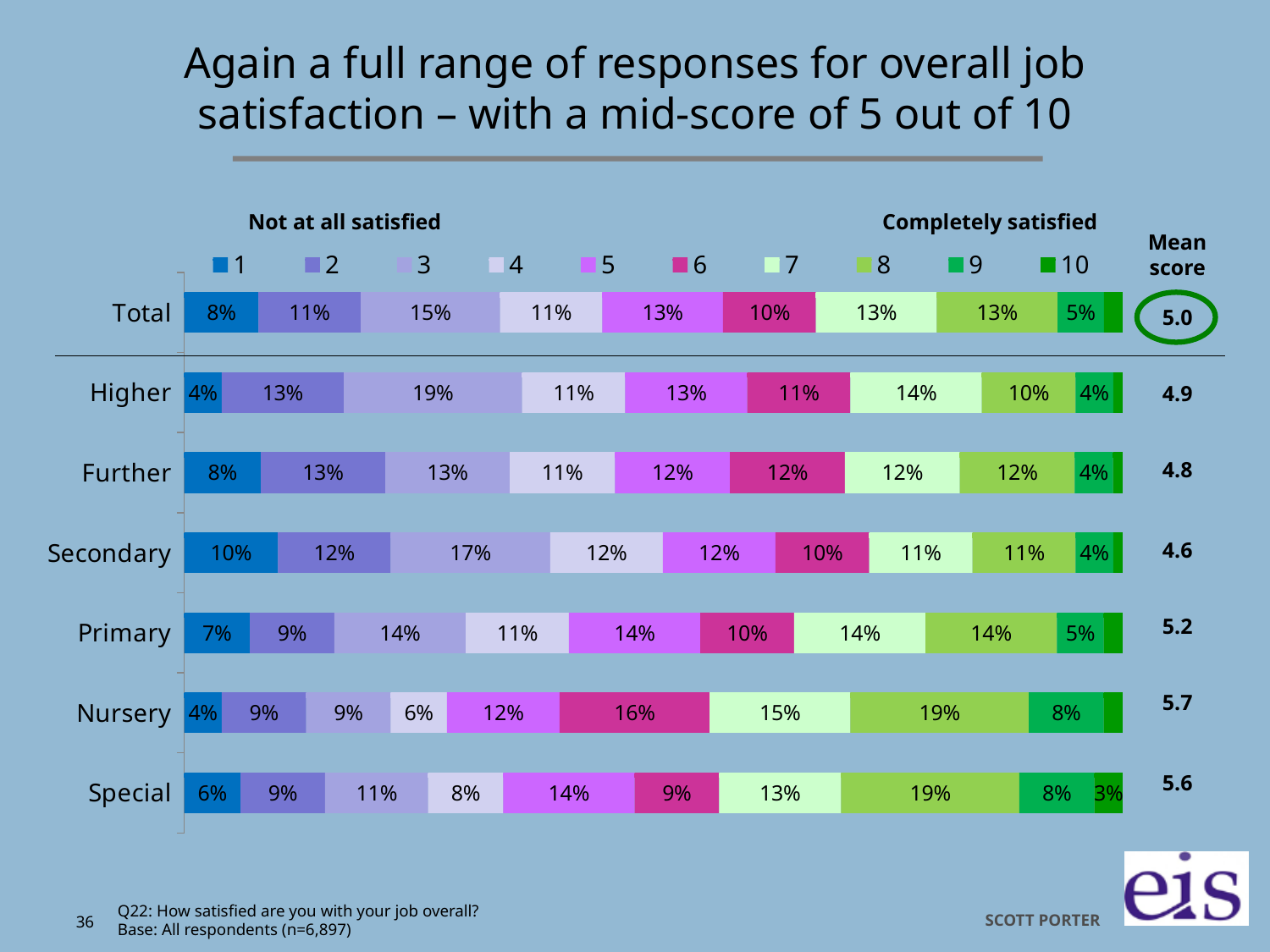
Which category has the lowest percentage giving a score of 4? Nursery What is the difference between the percentage giving a score of 8 for Nursery and for Primary? 5% Which category has the highest percentage giving a score of 6? Nursery Which is larger: the percentage giving a score of 6 for Nursery or for Special? Nursery How many categories (bars) are shown in the chart? 7 What is the mean score shown for the Nursery category? 5.7 What percentage of Nursery respondents gave a score of 8? 19% How many series does the legend list? 10 What percentage of Higher respondents gave a score of 3? 19% What percentage of Total respondents gave a score of 3? 15% What kind of chart is shown on the slide? Stacked bar chart What percentage of Special respondents gave a score of 10? 3%